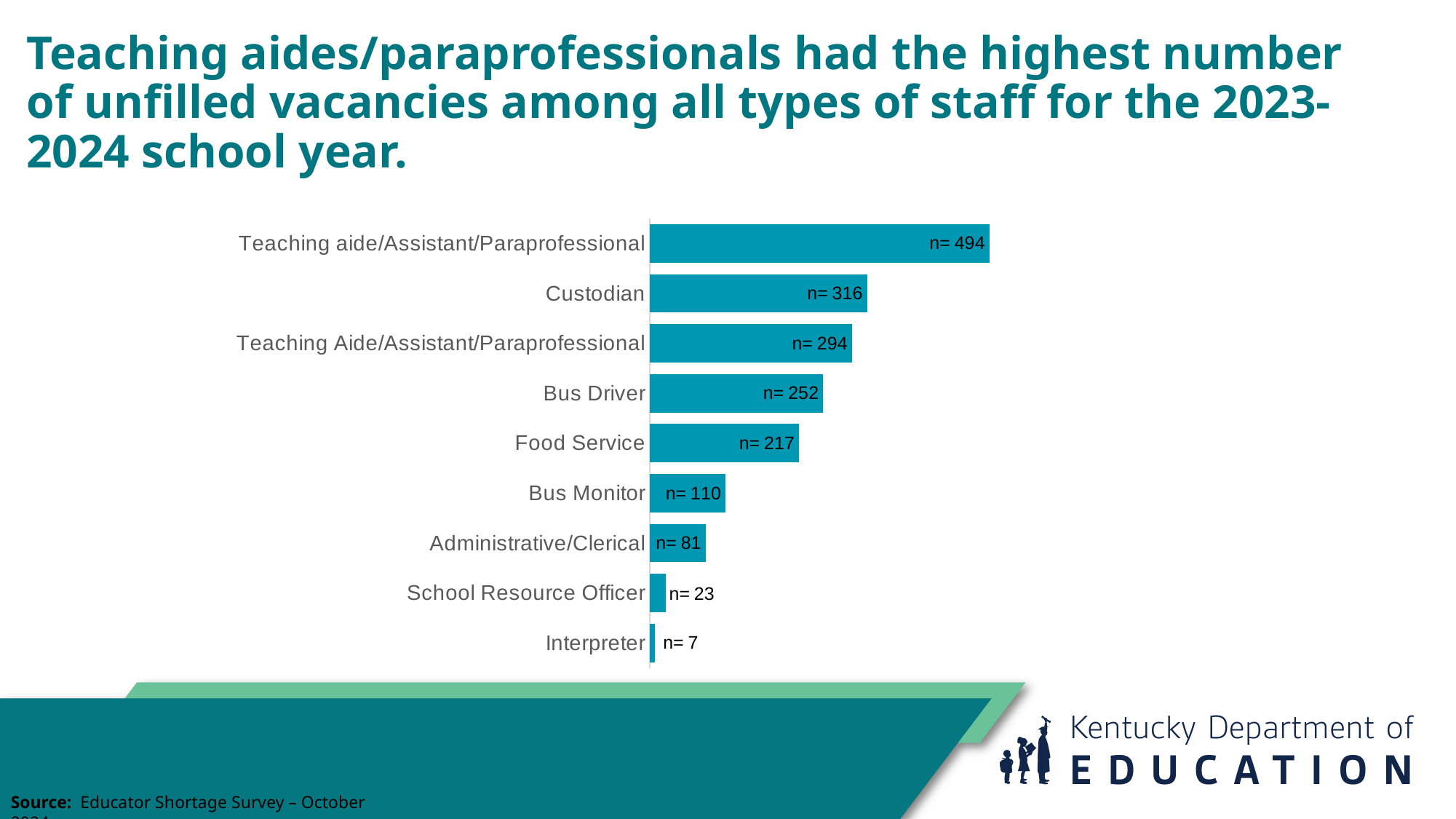
What kind of chart is shown on the slide? Bar chart What is the value for School Resource Officer? n= 23 How many categories are shown in the chart? 9 Which category has the lowest value? Interpreter What is the value for Food Service? n= 217 Which category has the highest value? Teaching aide/Assistant/Paraprofessional What is the value for Bus Driver? n= 252 What is the difference between the values for Custodian and Bus Driver? 64 What is the value for Custodian? n= 316 What is the difference between the values for Administrative/Clerical and Interpreter? 74 What is the value for Bus Monitor? n= 110 Which is larger, the value for Food Service or the value for Bus Monitor? Food Service